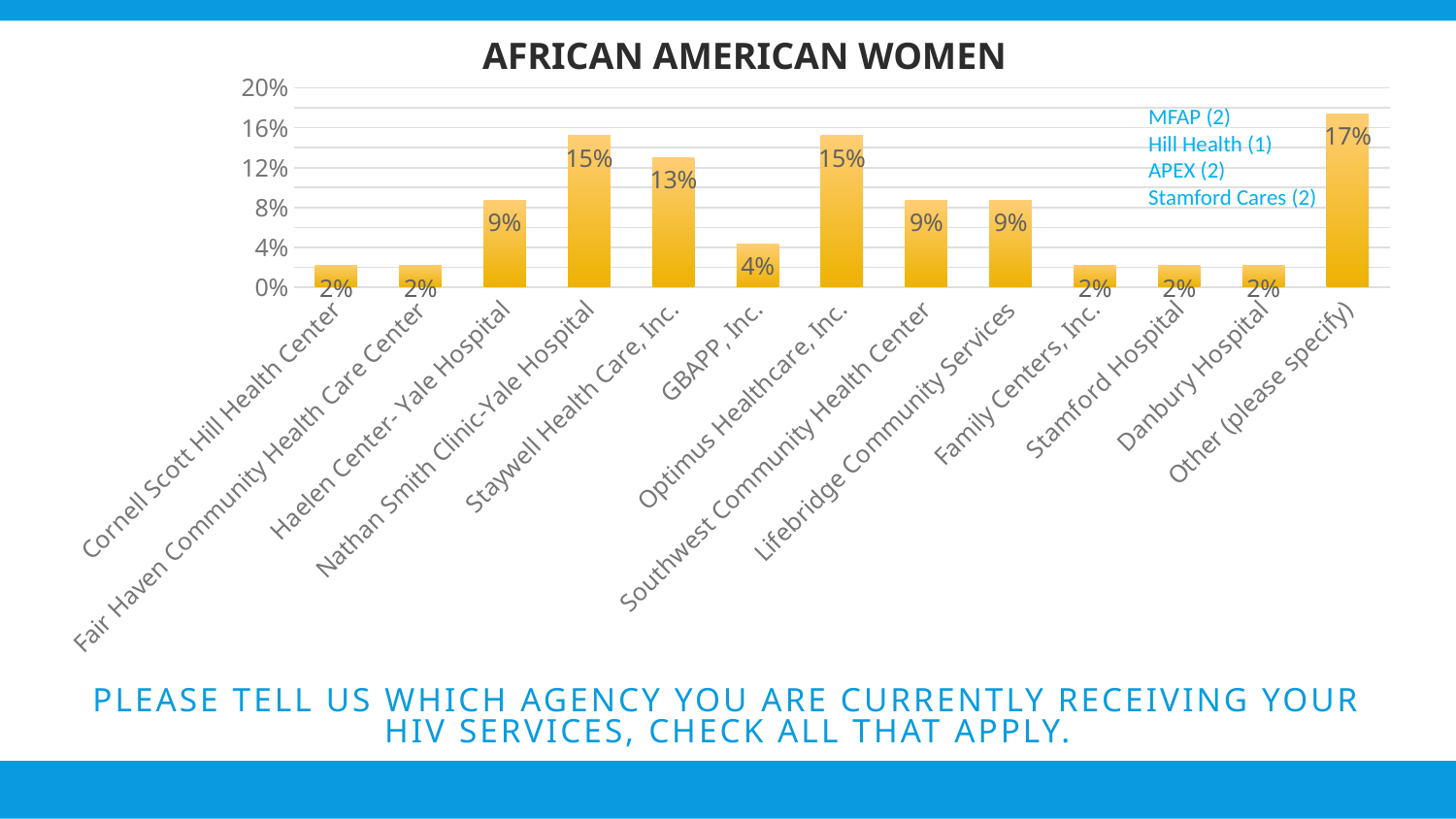
What is the value for Staywell Health Care, Inc.? 13% What is the difference between the values for Other (please specify) and Staywell Health Care, Inc.? 4% What is the value for Lifebridge Community Services? 9% What is the title of the chart? AFRICAN AMERICAN WOMEN Which category has the highest value? Other (please specify) Which is larger, the value for Haelen Center - Yale Hospital or the value for GBAPP, Inc.? Haelen Center - Yale Hospital What type of chart is shown on the slide? bar chart How many categories are shown on the x axis? 13 What is the value for Nathan Smith Clinic-Yale Hospital? 15% What is the difference between the values for Optimus Healthcare, Inc. and Family Centers, Inc.? 13% What is the value for Other (please specify)? 17% What is the value for GBAPP, Inc.? 4%